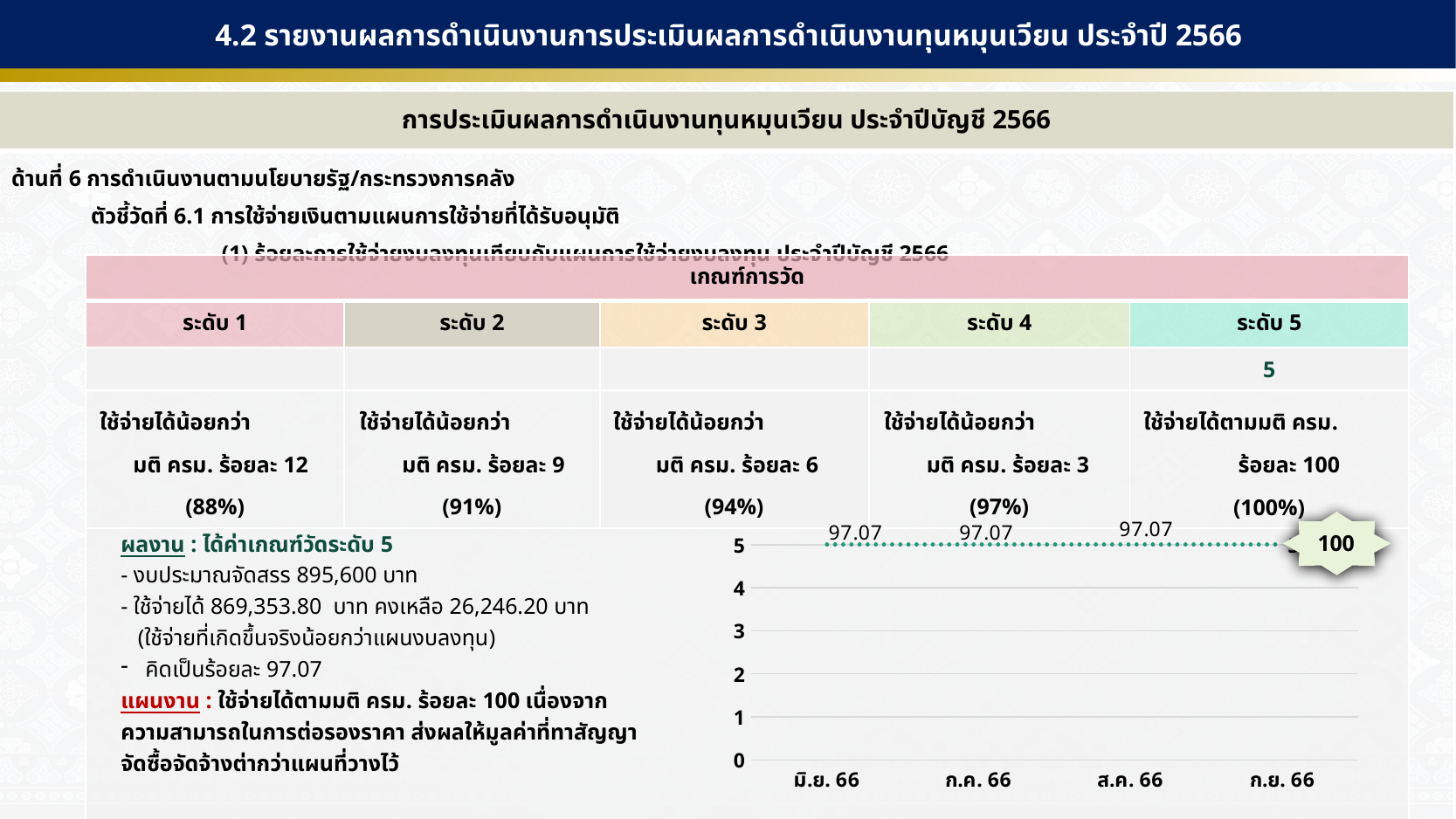
What value is shown in the callout at the ก.ย. 66 point of the chart? 100 What is the first category label on the x axis of the chart? มิ.ย. 66 What is the data label shown above the point for ก.ค. 66 in the chart? 97.07 What is the data label shown above the point for ส.ค. 66 in the chart? 97.07 Does the plotted line in the chart rise, fall, or stay flat from มิ.ย. 66 to ก.ย. 66? stays flat What kind of chart is shown at the bottom right of the slide? line chart What is the highest tick value shown on the y axis of the chart? 5 Is the plotted level for มิ.ย. 66 in the chart greater or less than 4 on the y axis? greater How many months are shown on the x axis of the chart? 4 What is the data label shown above the point for มิ.ย. 66 in the chart? 97.07